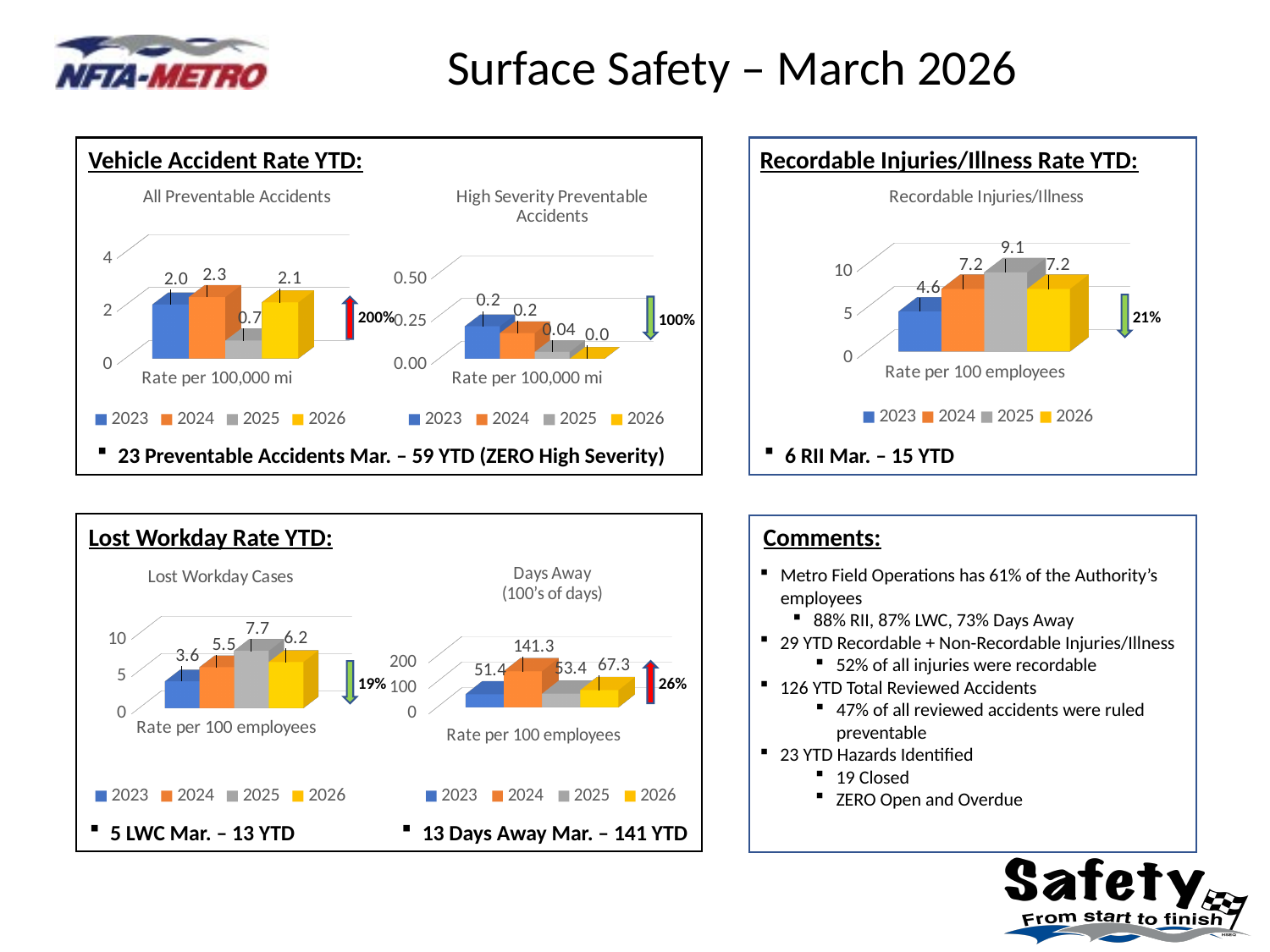
How many series does the legend of the Days Away chart list? 4 In the Days Away chart, what is the value for 2024? 141.3 In the Lost Workday Cases chart, what is the value for 2024? 5.5 In the All Preventable Accidents chart, what is the value for 2026? 2.1 In the All Preventable Accidents chart, which year has the lowest value? 2025 In the Lost Workday Cases chart, is the value for 2025 larger or smaller than the value for 2026? larger In the High Severity Preventable Accidents chart, what is the value for 2025? 0.04 In the Days Away chart, what is the difference between the 2026 and 2023 values? 15.9 What is the x-axis label of the Lost Workday Cases chart? Rate per 100 employees In the Recordable Injuries/Illness chart, which year has the highest value? 2025 In the Recordable Injuries/Illness chart, what is the difference between the 2025 and 2023 values? 4.5 What kind of chart is the Recordable Injuries/Illness chart? Bar chart